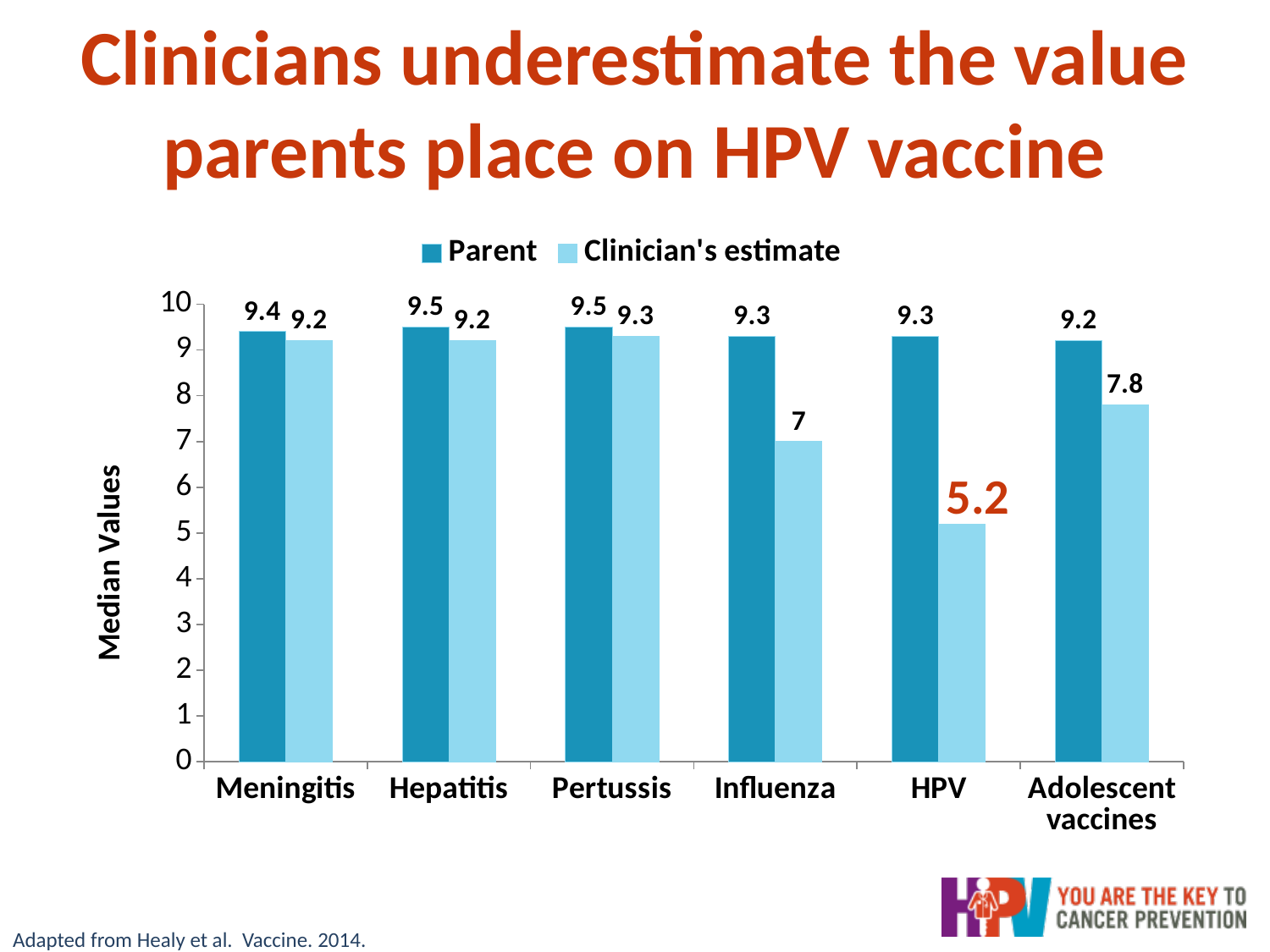
What is the Clinician's estimate for HPV? 5.2 What is the label of the y axis? Median Values Which is larger, the Clinician's estimate for Influenza or the Clinician's estimate for Adolescent vaccines? Adolescent vaccines What is the difference between the Parent value and the Clinician's estimate for HPV? 4.1 What kind of chart is shown on the slide? Bar chart What is the difference between the Parent value and the Clinician's estimate for Adolescent vaccines? 1.4 What is the Parent value for HPV? 9.3 How many categories are shown on the x axis? 6 What is the Parent value for Adolescent vaccines? 9.2 What is the Clinician's estimate for Influenza? 7 Which category has the lowest Clinician's estimate? HPV How many series does the legend list? 2